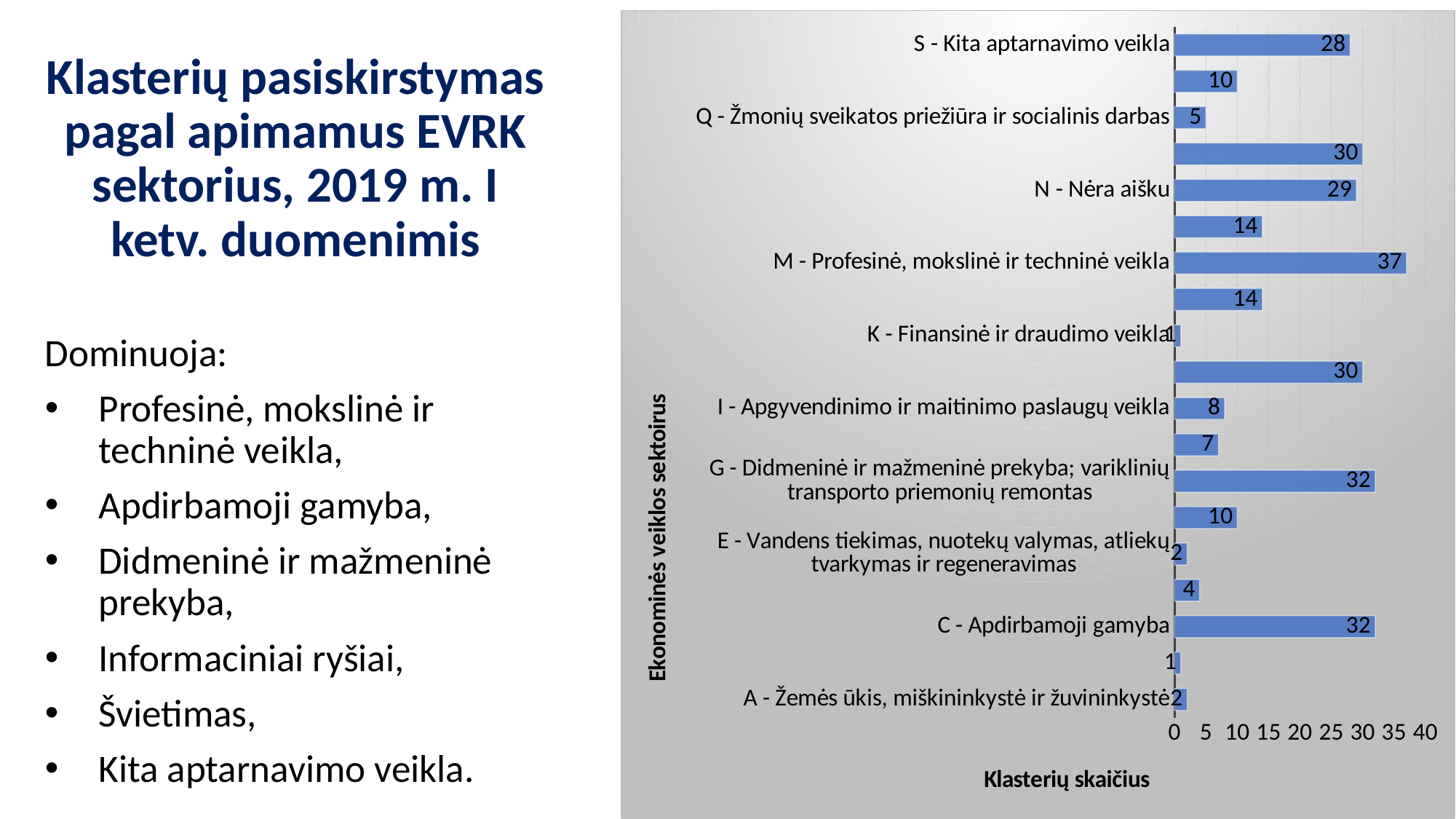
What is the title of the horizontal axis of the chart? Klasterių skaičius What is the value for I - Apgyvendinimo ir maitinimo paslaugų veikla? 8 Which is larger, the value for N - Nėra aišku or the value for Q - Žmonių sveikatos priežiūra ir socialinis darbas? N - Nėra aišku What is the difference between the values for M - Profesinė, mokslinė ir techninė veikla and S - Kita aptarnavimo veikla? 9 What is the value for M - Profesinė, mokslinė ir techninė veikla? 37 What is the value for S - Kita aptarnavimo veikla? 28 Is the value for M - Profesinė, mokslinė ir techninė veikla greater or less than 35? greater What is the value for Q - Žmonių sveikatos priežiūra ir socialinis darbas? 5 Which category has the highest value? M - Profesinė, mokslinė ir techninė veikla How many bars are plotted in the chart? 19 What kind of chart is shown on the slide? bar chart What is the value for C - Apdirbamoji gamyba? 32